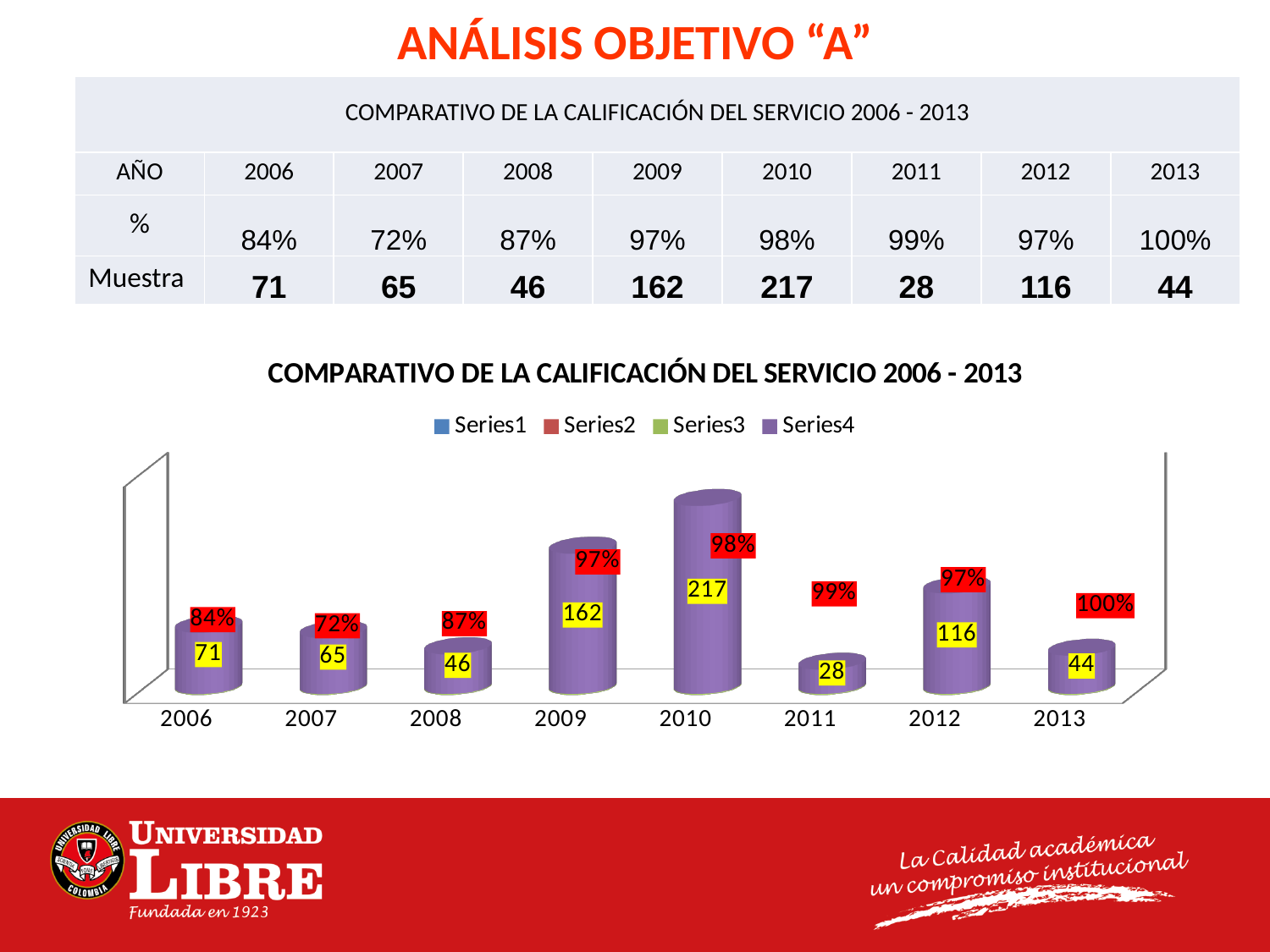
What is the difference between the bar values for 2010 and 2009? 55 What is the title of the chart? COMPARATIVO DE LA CALIFICACIÓN DEL SERVICIO 2006 - 2013 How many years are shown on the x axis of the chart? 8 What is the value shown on the bar for 2010? 217 What percentage label is shown above the bar for 2013? 100% How many series does the chart legend list? 4 What percentage label is shown above the bar for 2007? 72% Which year has the shortest bar? 2011 Which bar is taller, 2012 or 2006? 2012 What type of chart is shown on the slide? bar chart Which year has the tallest bar? 2010 What is the value shown on the bar for 2008? 46